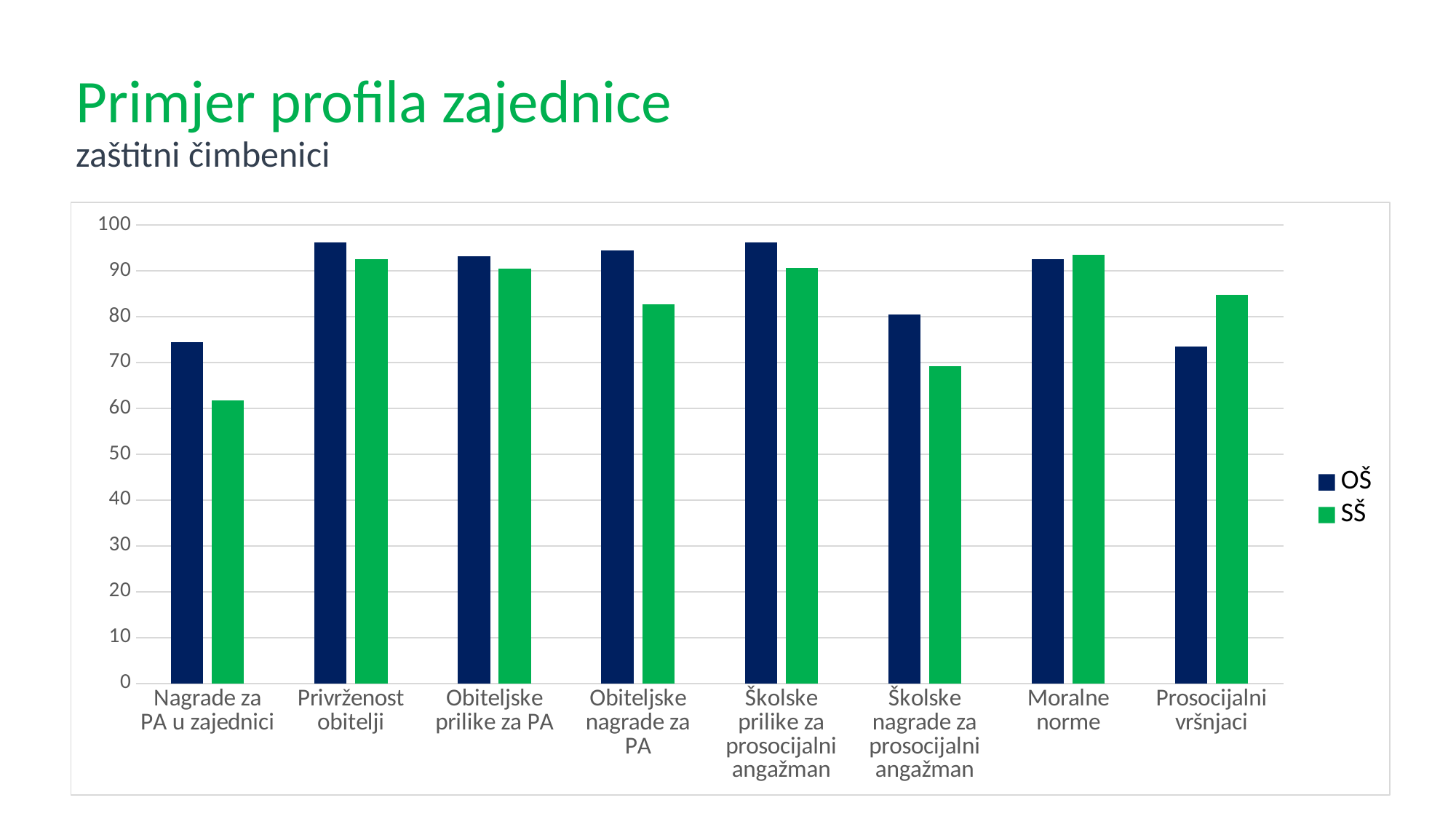
For Prosocijalni vršnjaci, which is larger, OŠ or SŠ? SŠ How many categories are shown on the x axis? 8 Is the OŠ value for Privrženost obitelji greater or less than 90? greater What kind of chart is shown on the slide? bar chart Is the SŠ value for Školske nagrade za prosocijalni angažman greater or less than 80? less For Nagrade za PA u zajednici, which is larger, OŠ or SŠ? OŠ What colour are the bars for the SŠ series? green How many series does the legend list? 2 Is the SŠ value for Nagrade za PA u zajednici greater or less than 70? less Which category has the lowest value for SŠ? Nagrade za PA u zajednici For Školske nagrade za prosocijalni angažman, which is larger, OŠ or SŠ? OŠ